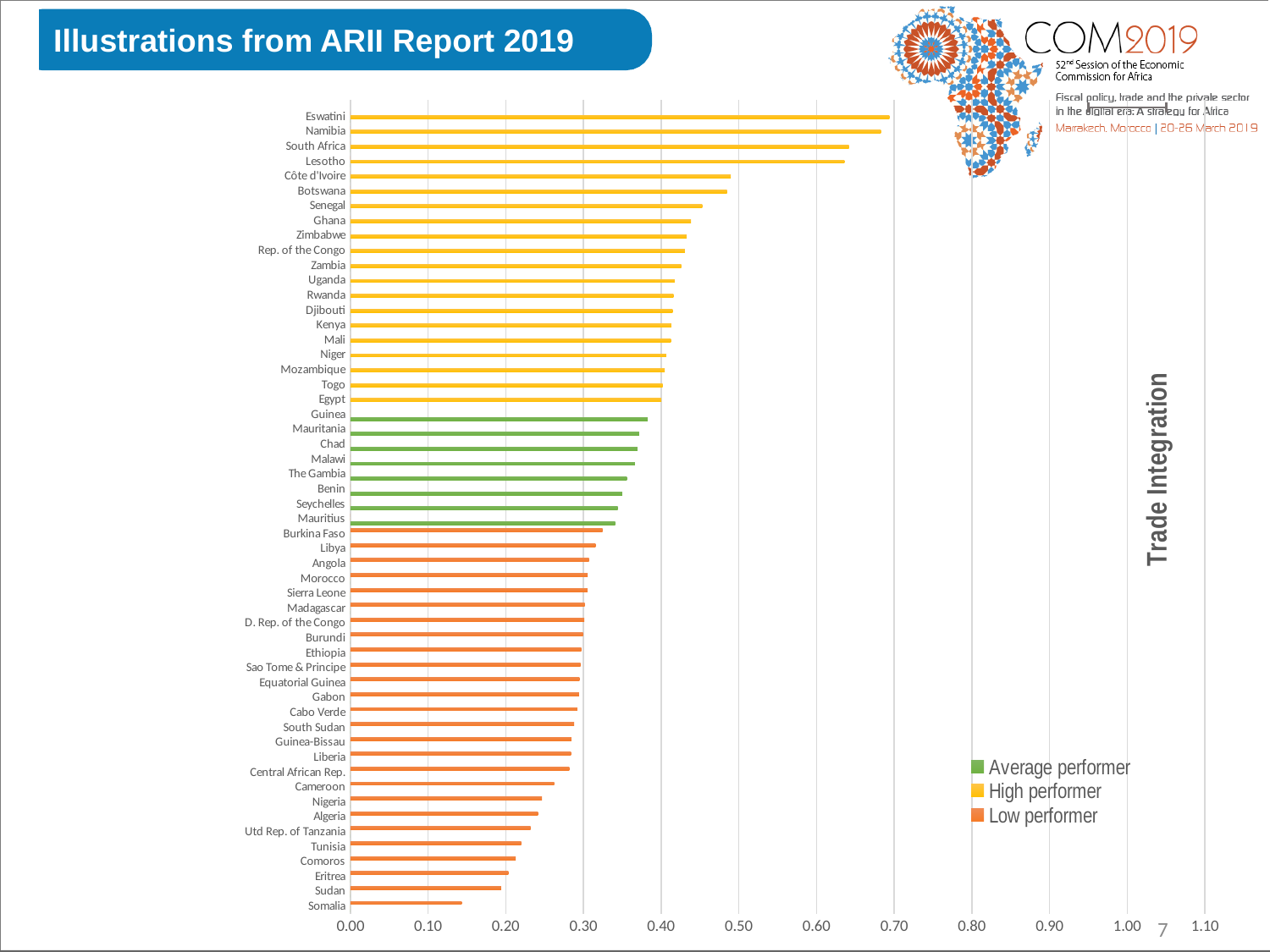
How many countries are plotted on the chart? 54 Is the value for Eswatini greater or less than 0.60? greater Which has the larger value, Sudan or Somalia? Sudan What is the axis title shown on the right side of the chart? Trade Integration Is the value for Somalia greater or less than 0.20? less What kind of chart is shown on the slide? bar chart Is the value for Côte d'Ivoire greater or less than 0.40? greater Which country has the highest Trade Integration value? Eswatini Which country has the lowest Trade Integration value? Somalia How many series does the legend list? 3 Which has the larger value, Namibia or South Africa? Namibia